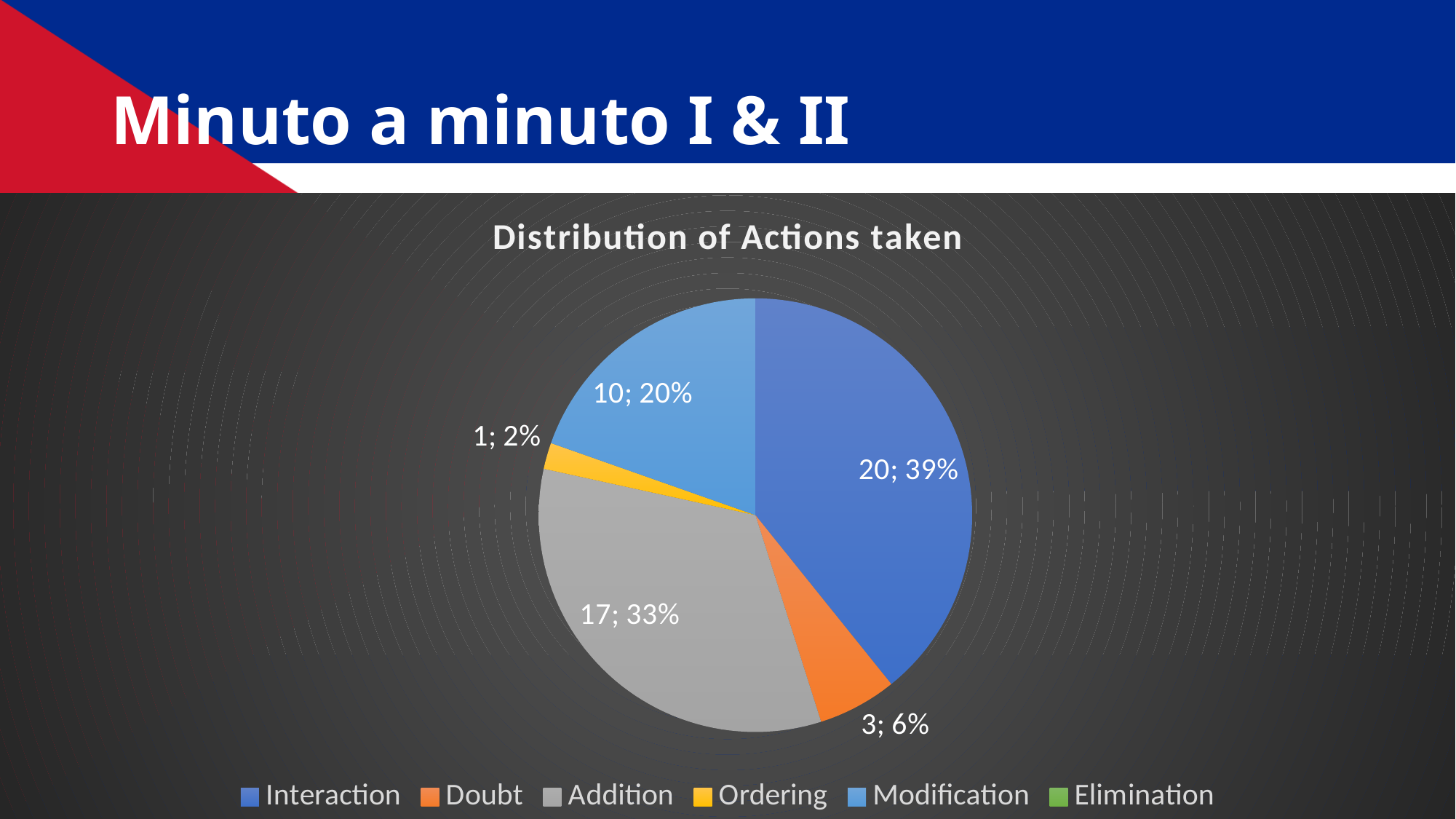
Which is larger, the Modification slice or the Doubt slice? Modification What percentage share does Ordering have? 2% What is the title of the chart? Distribution of Actions taken What is the difference in count between Interaction and Addition? 3 What is the count shown for Modification? 10 Which category with a visible slice has the smallest share? Ordering What kind of chart is shown on the slide? pie chart What is the count shown for Interaction? 20 What percentage share does Addition have? 33% Which category has the largest slice? Interaction How many categories does the legend list? 6 What percentage share does Doubt have? 6%